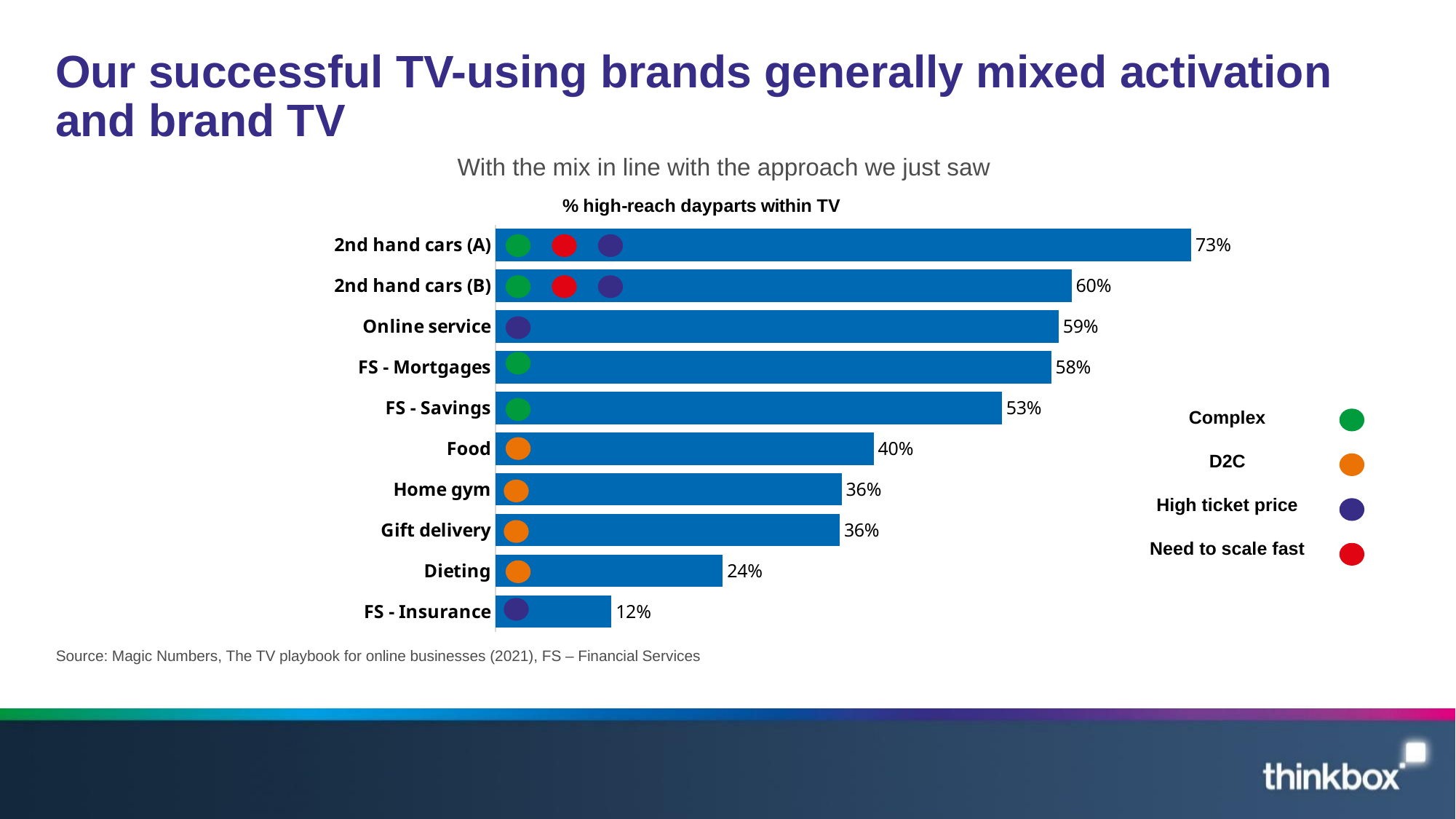
Which category has the highest % high-reach dayparts within TV? 2nd hand cars (A) How many categories are shown in the bar chart? 10 What is the value shown for FS - Savings? 53% Which legend entry is represented by the orange dot? D2C What kind of chart is shown on the slide? Bar chart Which has a higher value, FS - Mortgages or FS - Savings? FS - Mortgages What is the difference between the values for Food and Dieting? 16% How many entries does the legend list? 4 Which category has the lowest % high-reach dayparts within TV? FS - Insurance What is the value shown for Dieting? 24% What is the difference between the values for 2nd hand cars (A) and 2nd hand cars (B)? 13% What is the % high-reach dayparts within TV for Online service? 59%